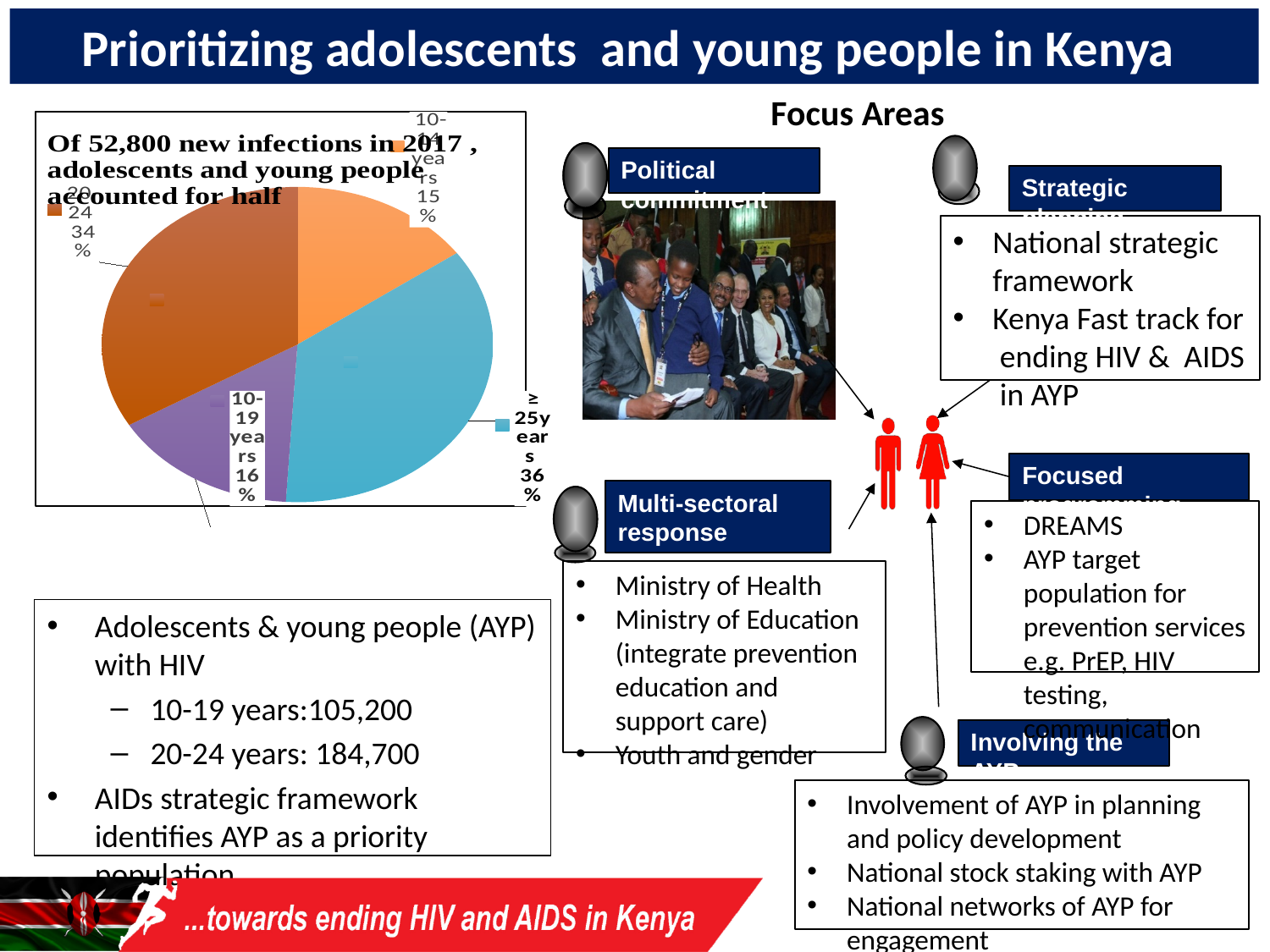
In the pie chart, what share of new infections is attributed to the ≥25 years group? 36% What kind of chart is shown on the left of the slide? pie chart According to the chart title, how many new infections were there in 2017? 52,800 In the pie chart, what is the difference in percentage points between the ≥25 years slice and the 20-24 slice? 2 percentage points In the pie chart, what percentage is shown for the 10-14 years group? 15% In the pie chart, what is the difference in percentage points between the 20-24 slice and the 10-14 years slice? 19 percentage points Which age group has the smallest slice in the pie chart? 10-14 years In the pie chart, what percentage is shown for the 20-24 group? 34% In the pie chart, which is larger: the 20-24 slice or the 10-19 years slice? 20-24 How many slices does the pie chart have? 4 Which age group has the largest slice in the pie chart? ≥25 years In the pie chart, what percentage is shown for the 10-19 years group? 16%